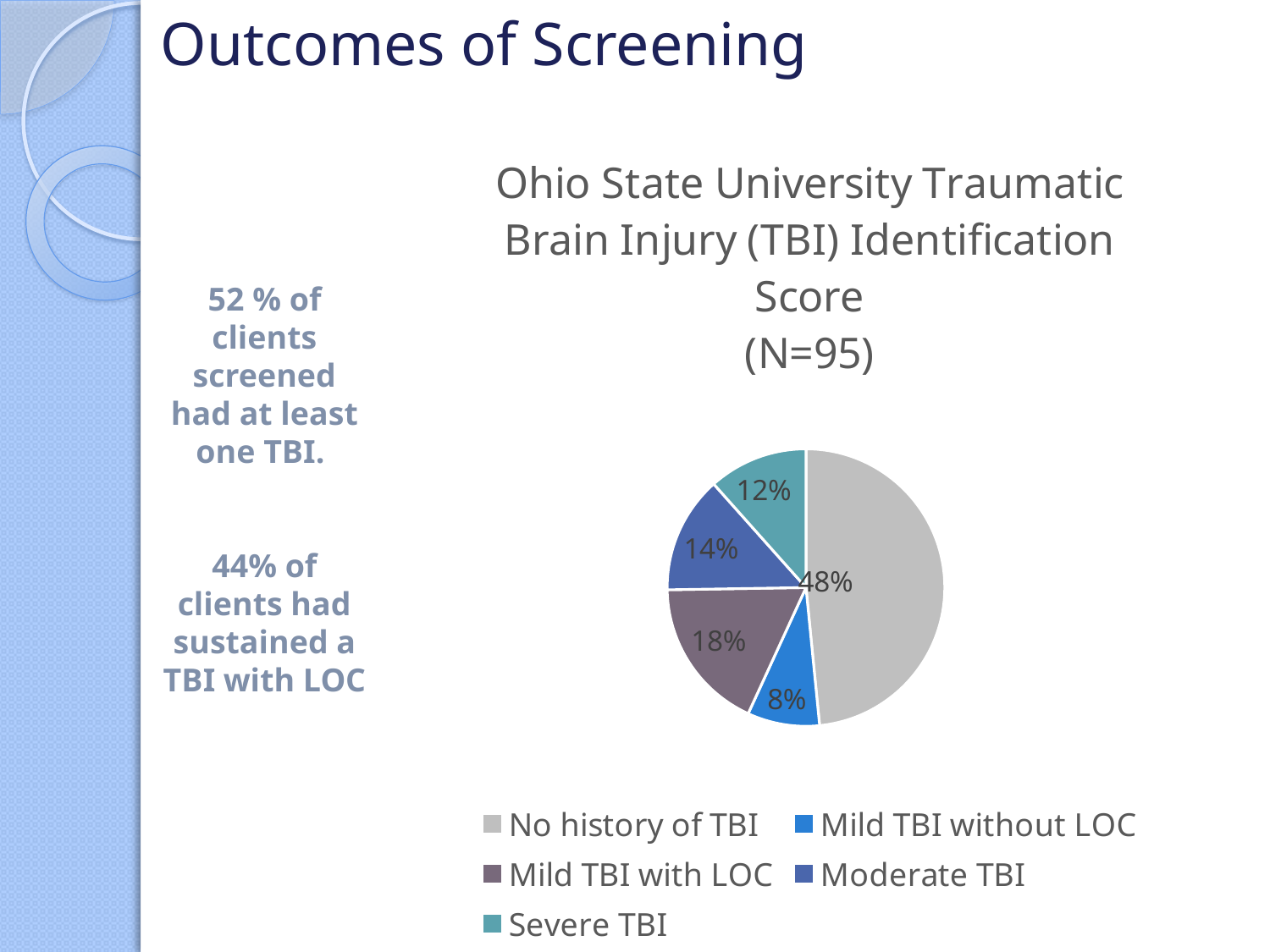
What percentage of clients had a severe TBI? 12% Which category has the largest share of the pie? No history of TBI Which is larger, the share for Moderate TBI or the share for Severe TBI? Moderate TBI What percentage of clients had no history of TBI? 48% How many categories does the pie chart legend list? 5 What is the difference in percentage points between Mild TBI with LOC and Mild TBI without LOC? 10 What percentage of clients had a mild TBI with LOC? 18% Which category has the smallest share of the pie? Mild TBI without LOC What percentage of clients had a mild TBI without LOC? 8% What percentage of clients had a moderate TBI? 14% What sample size (N) is stated in the chart title? N=95 What type of chart is shown on the slide? Pie chart